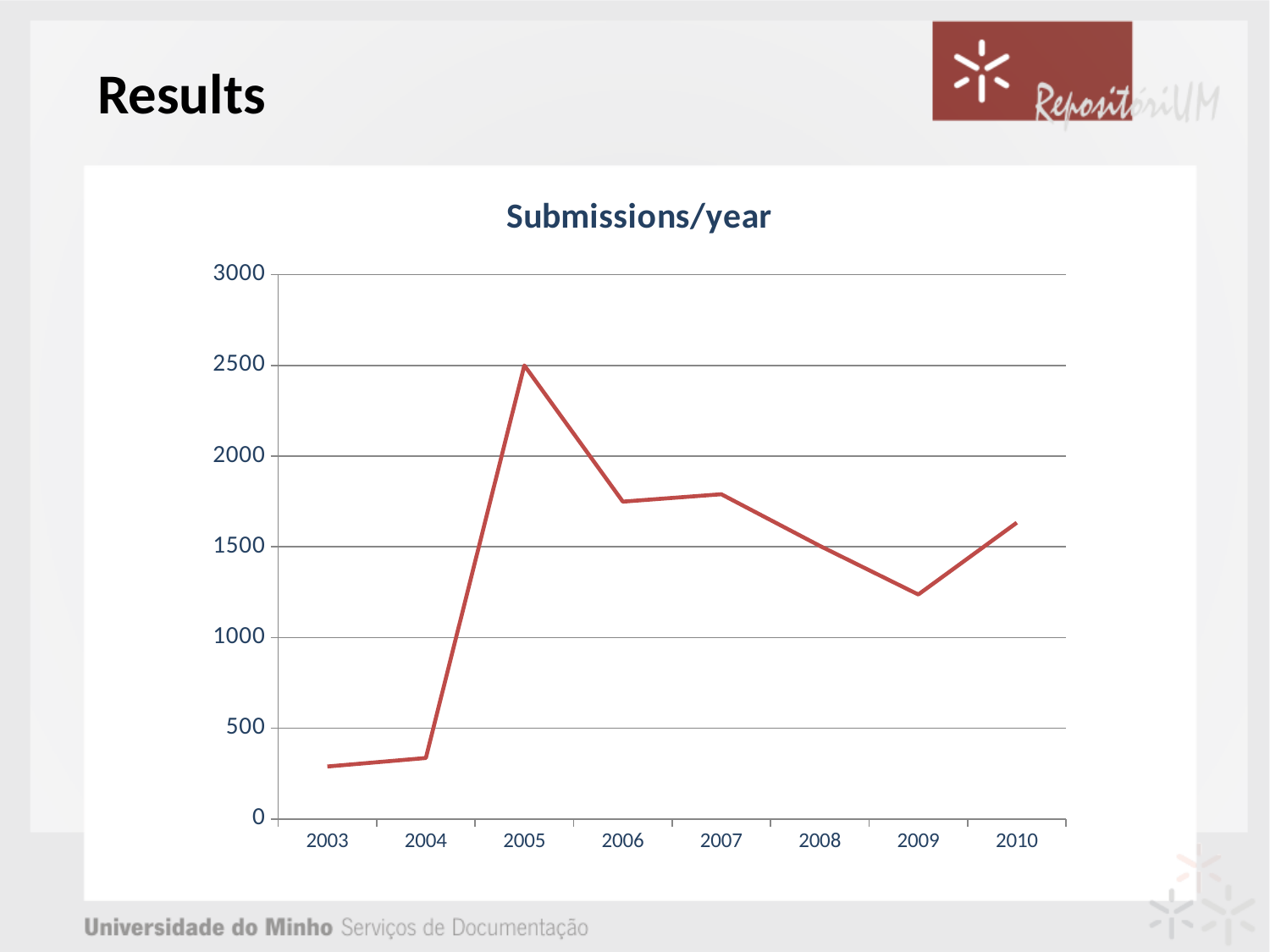
What is the title of the chart? Submissions/year How many years are plotted on the x axis of the chart? 8 Is the value for 2006 greater or less than 1500? greater Is the value for 2005 greater or less than 2000? greater Is the value for 2009 greater or less than 1500? less What kind of chart is shown on the slide? line chart Do the submissions rise or fall from 2005 to 2009? fall Which year has the lowest number of submissions? 2003 Which year has more submissions, 2004 or 2009? 2009 Which year has more submissions, 2008 or 2010? 2010 Which year has the highest number of submissions? 2005